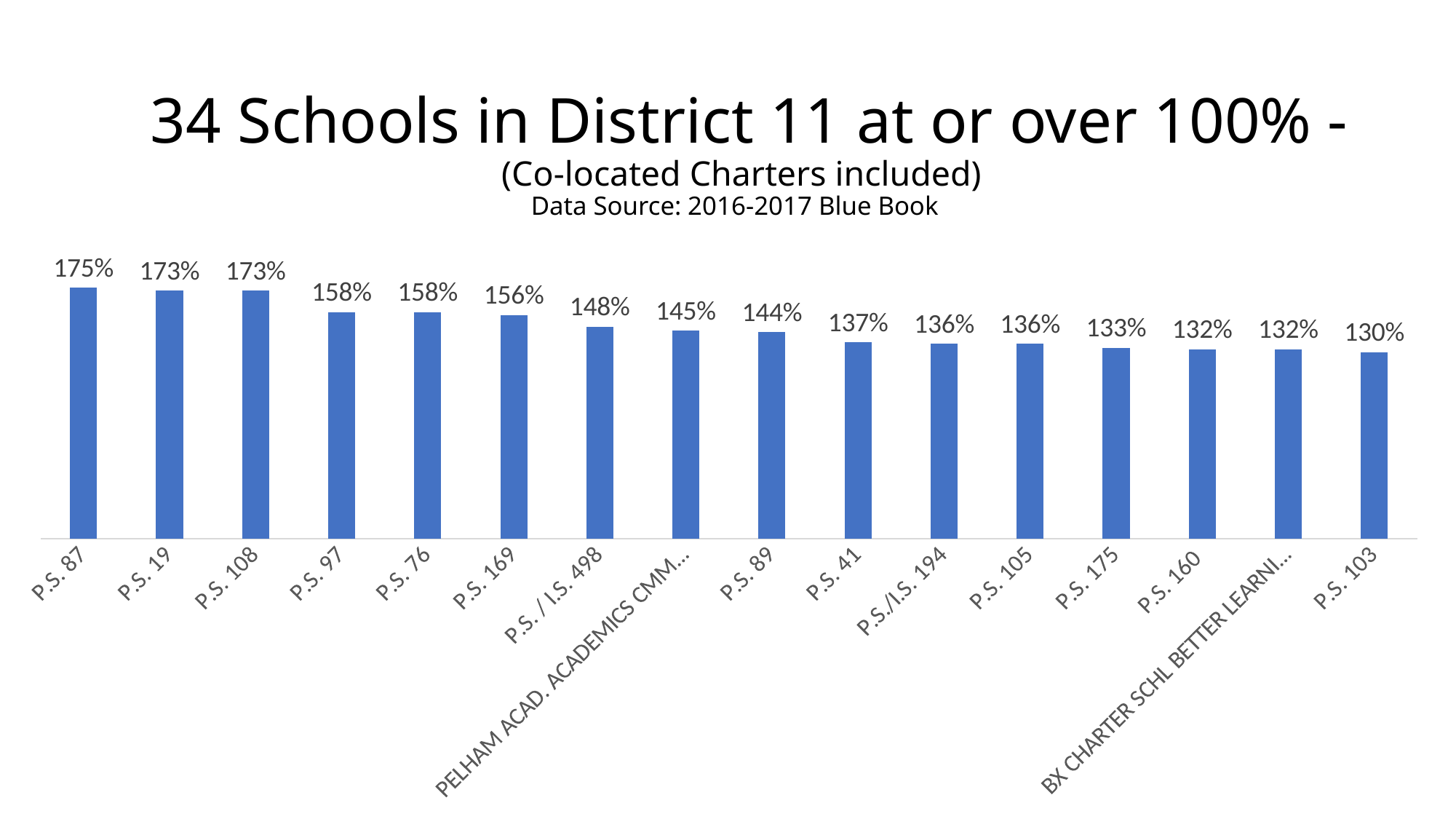
What is the value for P.S. 87? 175% Do the values rise or fall from left to right along the x axis? Fall What is the value for P.S. 103? 130% Which has a larger value, P.S. / I.S. 498 or P.S. 175? P.S. / I.S. 498 What is the difference between the values for P.S. 87 and P.S. 103? 45% What is the value for P.S. 169? 156% What is the value for P.S. 89? 144% How many schools are shown in the chart? 16 What kind of chart is shown on the slide? Bar chart Which school has the lowest value? P.S. 103 What is the difference between the values for P.S. 97 and P.S. 41? 21% Which school has the highest value? P.S. 87